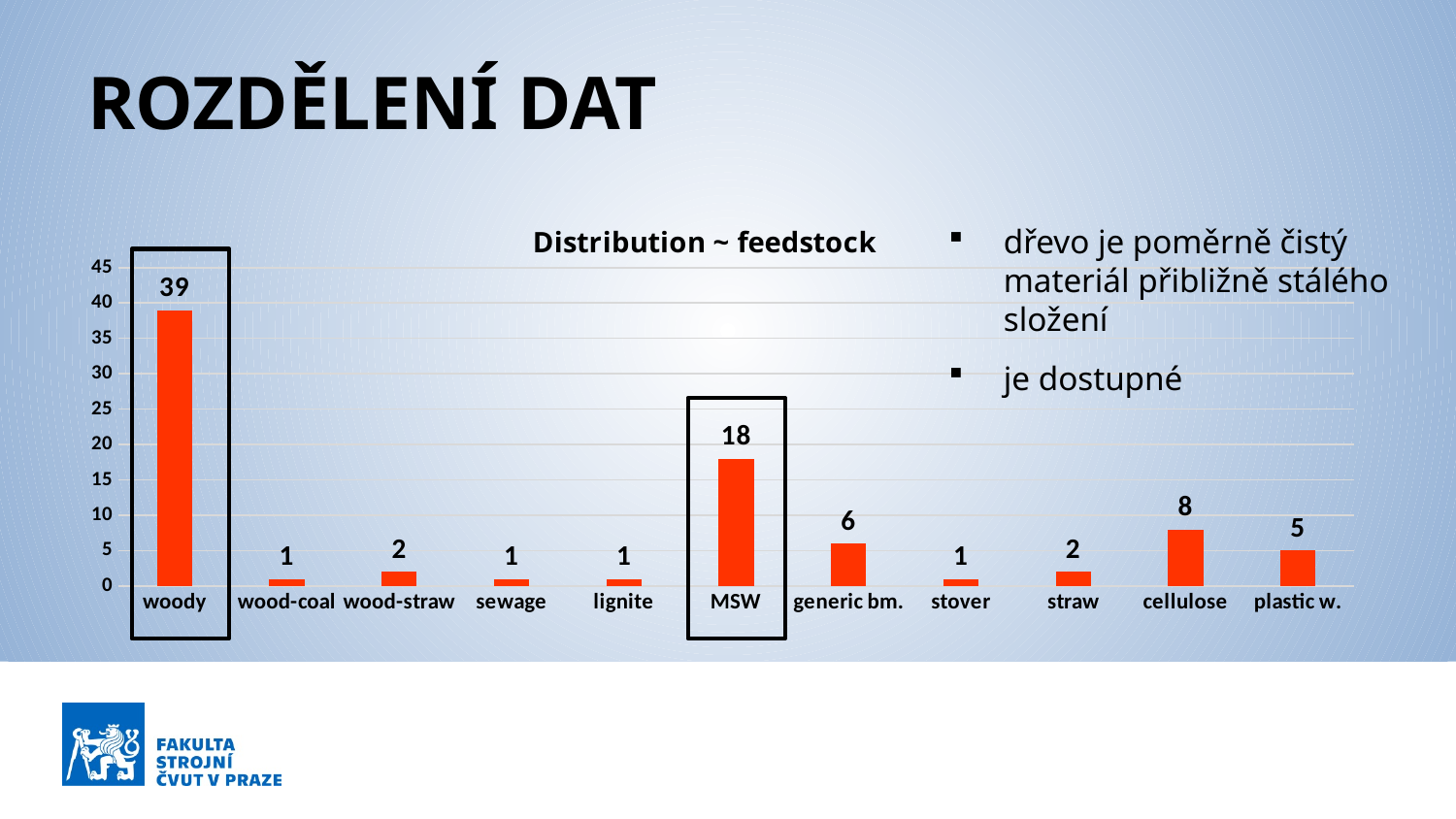
What is the difference between the values for woody and MSW? 21 What is the value for MSW? 18 What is the value for woody? 39 How many categories are shown on the x axis? 11 Is the value for woody greater or less than 35? greater What is the value for plastic w.? 5 What is the difference between the values for cellulose and plastic w.? 3 Which is larger, the value for generic bm. or the value for cellulose? cellulose What kind of chart is shown on the slide? bar chart What is the title of the chart? Distribution ~ feedstock Which category has the highest value? woody What is the value for cellulose? 8